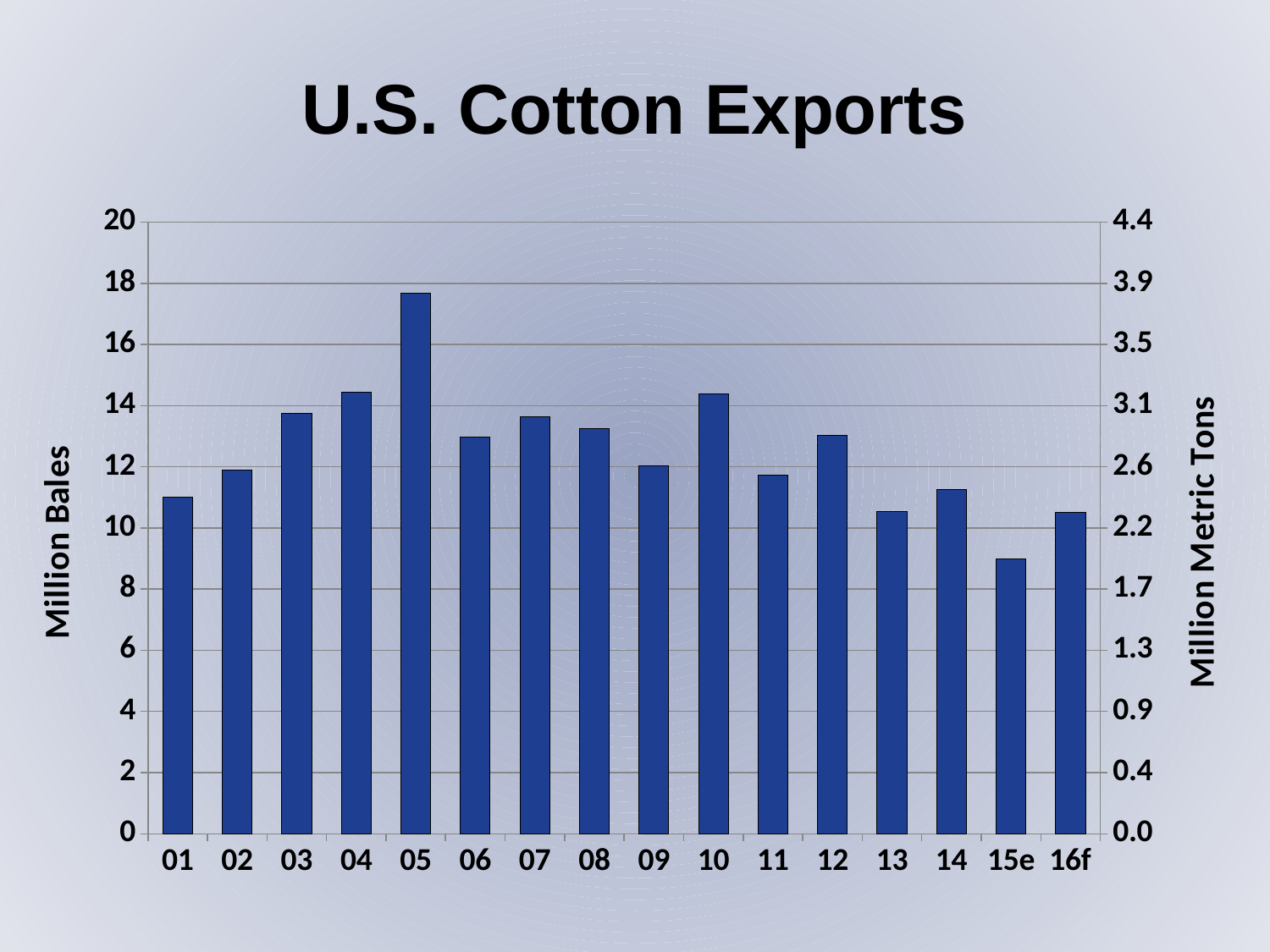
Is the value for 09 greater or less than 14 million bales? less What is the label on the left vertical axis? Million Bales Which year has the highest U.S. cotton exports? 05 Which is larger, the value for 05 or the value for 10? 05 Is the value for 04 greater or less than 14 million bales? greater Is the value for 05 greater or less than 16 million bales? greater Which year has the lowest U.S. cotton exports? 15e Which is larger, the value for 03 or the value for 13? 03 How many years (bars) are shown on the chart? 16 What kind of chart is shown on the slide? bar chart Do the values rise or fall from 01 to 05? rise